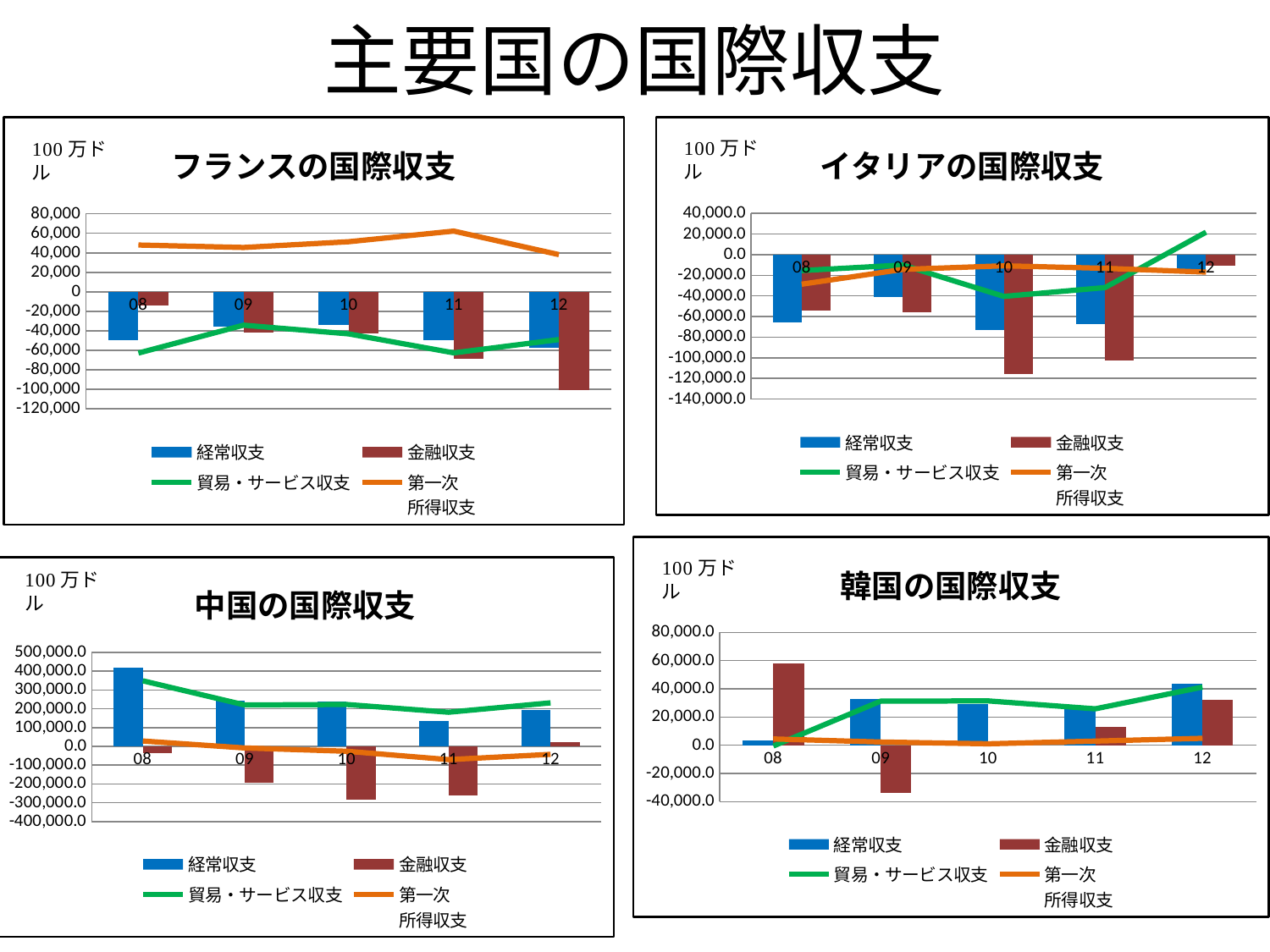
In the フランスの国際収支 chart, in which year does the 第一次所得収支 line reach its highest point? 11 In the イタリアの国際収支 chart, in which year is the 金融収支 bar lowest? 10 In the フランスの国際収支 chart, is the 金融収支 value for 12 greater or less than -80,000? less What kind of chart is the 韓国の国際収支 chart? Combined bar and line chart In the 韓国の国際収支 chart, which is larger, the 経常収支 value for 08 or for 12? 12 In the 中国の国際収支 chart, how many years are plotted on the x axis? 5 In the 中国の国際収支 chart, in which year is the 経常収支 bar highest? 08 In the フランスの国際収支 chart, how many series does the legend list? 4 How many charts are shown on the slide? 4 In the イタリアの国際収支 chart, is the 貿易・サービス収支 value for 12 greater or less than 0.0? greater In the 中国の国際収支 chart, is the 経常収支 value for 08 greater or less than 300,000.0? greater In the フランスの国際収支 chart, in which year is the 金融収支 bar lowest? 12